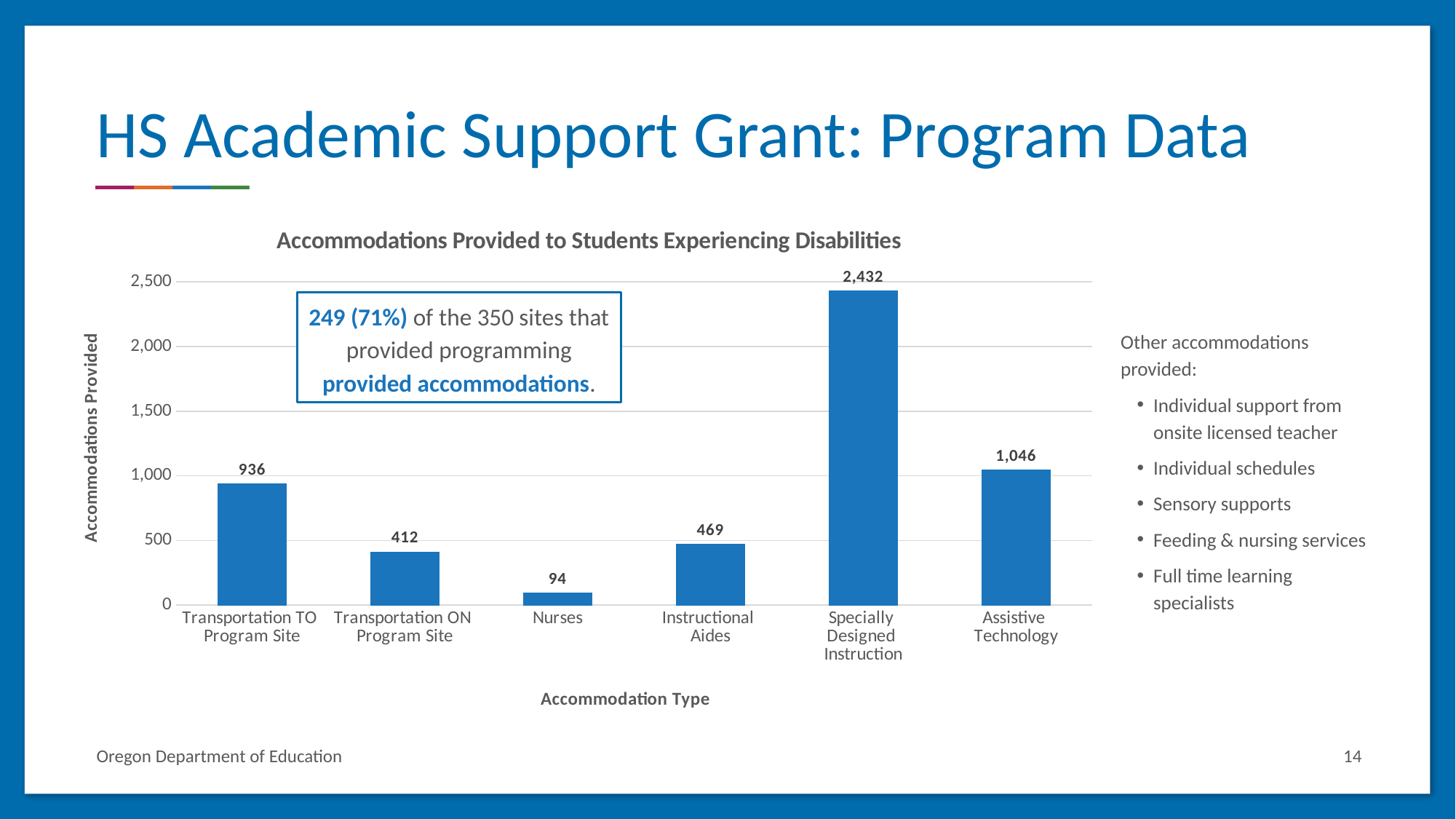
What is the title of the chart? Accommodations Provided to Students Experiencing Disabilities Which is larger, Instructional Aides or Transportation ON Program Site? Instructional Aides What is the difference between Instructional Aides and Transportation ON Program Site? 57 Which accommodation type has the highest value? Specially Designed Instruction What is the difference between Assistive Technology and Transportation TO Program Site? 110 Is the value for Assistive Technology greater or less than 1,000? greater Which accommodation type has the lowest value? Nurses How many accommodation types are shown on the x axis? 6 What is the value for Nurses? 94 What kind of chart is shown on the slide? bar chart What is the value for Transportation TO Program Site? 936 What is the value for Specially Designed Instruction? 2,432